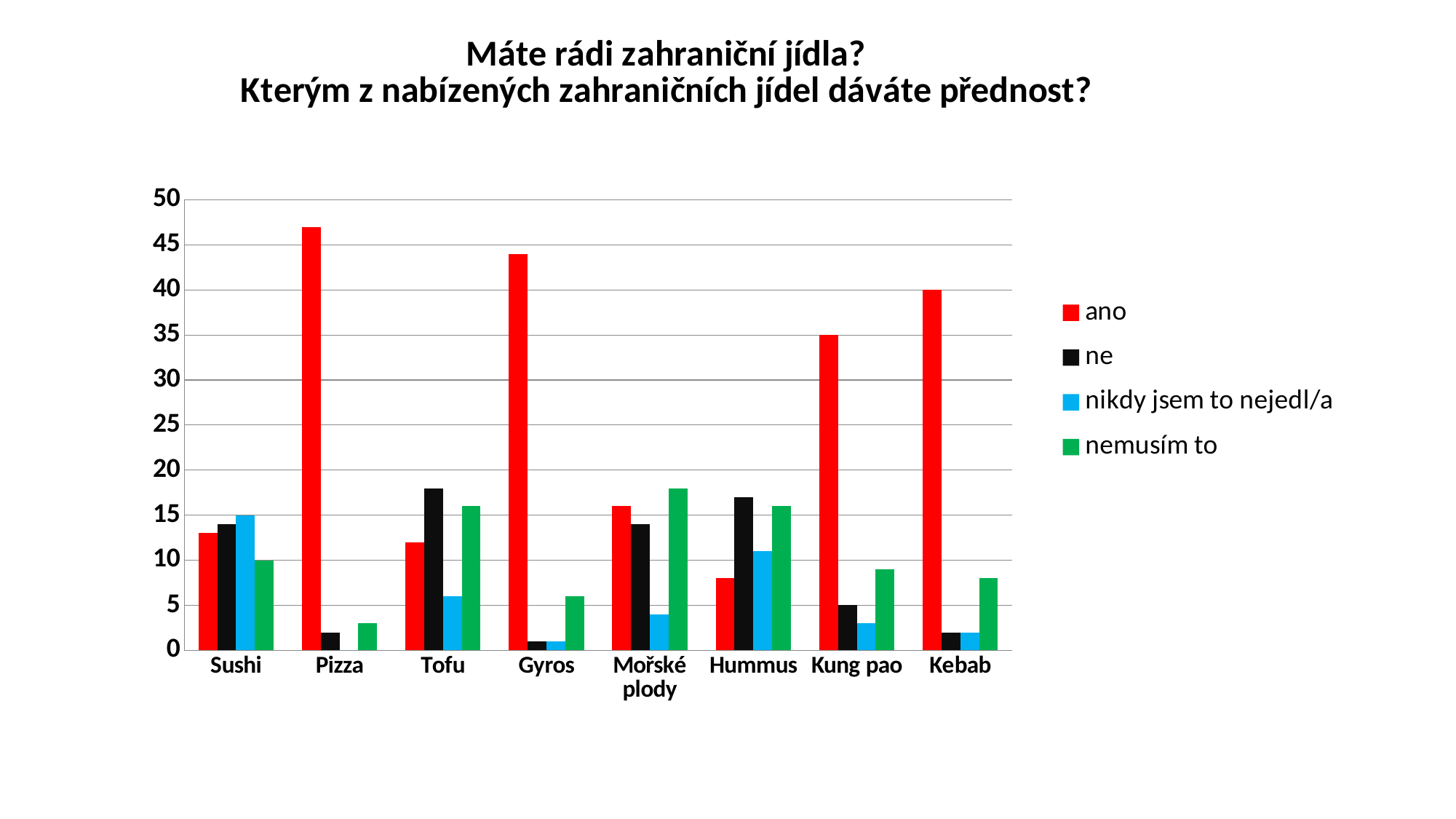
How many series does the legend list? 4 Is the 'ano' value for Tofu greater or less than 15? less Which is larger: the 'ano' value for Kebab or the 'ano' value for Kung pao? Kebab Which food has the highest 'ne' value? Tofu Is the 'ano' value for Pizza greater or less than 45? greater Which food has the highest 'ano' value? Pizza What kind of chart is shown on the slide? bar chart How many food categories are shown on the x axis? 8 Which is larger: the 'nemusím to' value for Mořské plody or the 'nemusím to' value for Pizza? Mořské plody Which food has the lowest 'ano' value? Hummus Is the 'ano' value for Gyros greater or less than 40? greater Which colour represents the 'nikdy jsem to nejedl/a' series? blue